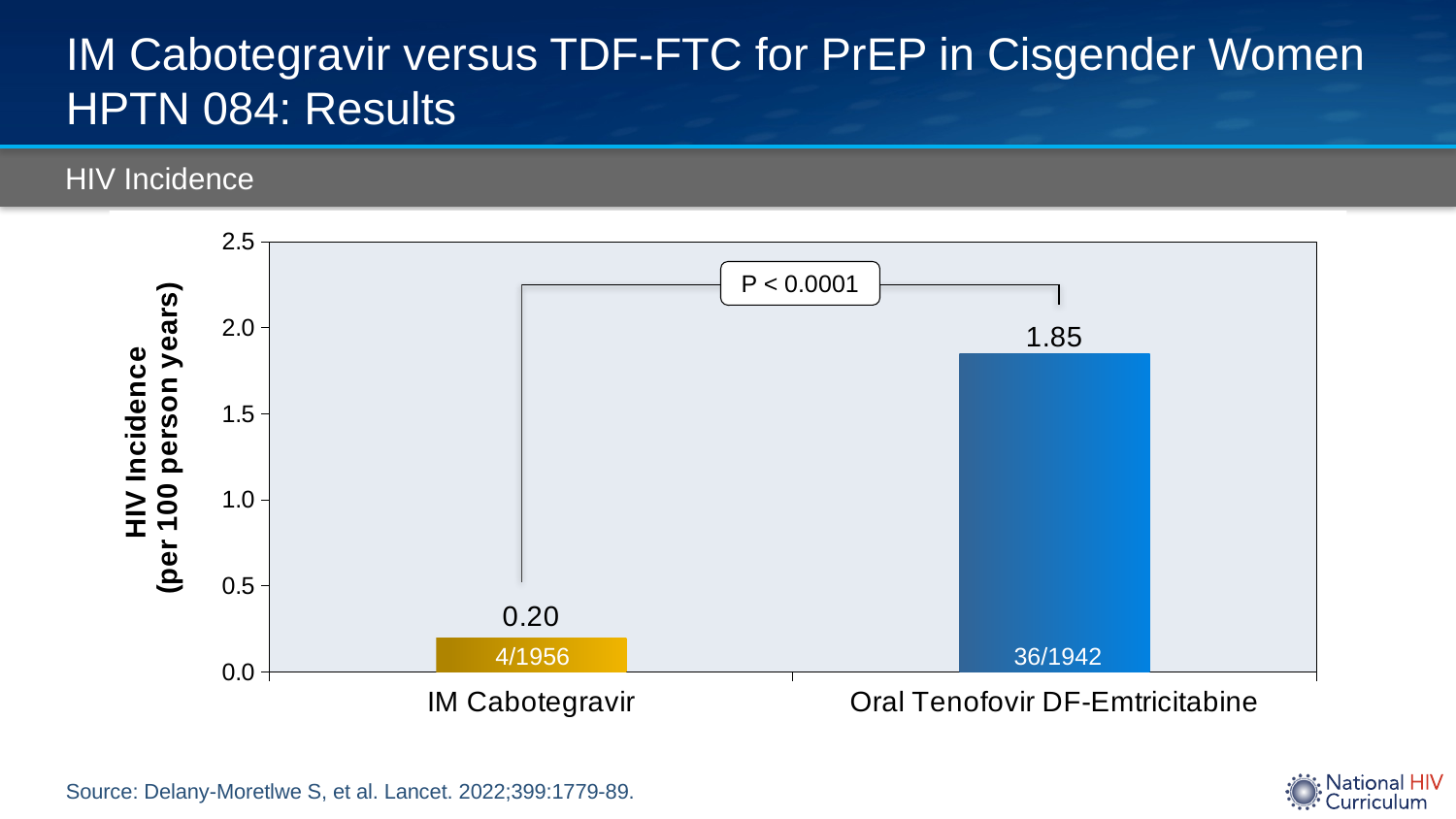
What is the difference in HIV incidence between Oral Tenofovir DF-Emtricitabine and IM Cabotegravir? 1.65 What is the HIV incidence per 100 person years for Oral Tenofovir DF-Emtricitabine? 1.85 Which group has the lower HIV incidence? IM Cabotegravir What kind of chart is shown on the slide? Bar chart What is the HIV incidence per 100 person years for IM Cabotegravir? 0.20 Is the HIV incidence for IM Cabotegravir greater or less than 0.5? less Is the HIV incidence for Oral Tenofovir DF-Emtricitabine greater or less than 1.5? greater What fraction is printed inside the IM Cabotegravir bar? 4/1956 What fraction is printed inside the Oral Tenofovir DF-Emtricitabine bar? 36/1942 What P value is shown on the chart? P < 0.0001 How many groups are shown on the chart? 2 Which group has the higher HIV incidence? Oral Tenofovir DF-Emtricitabine